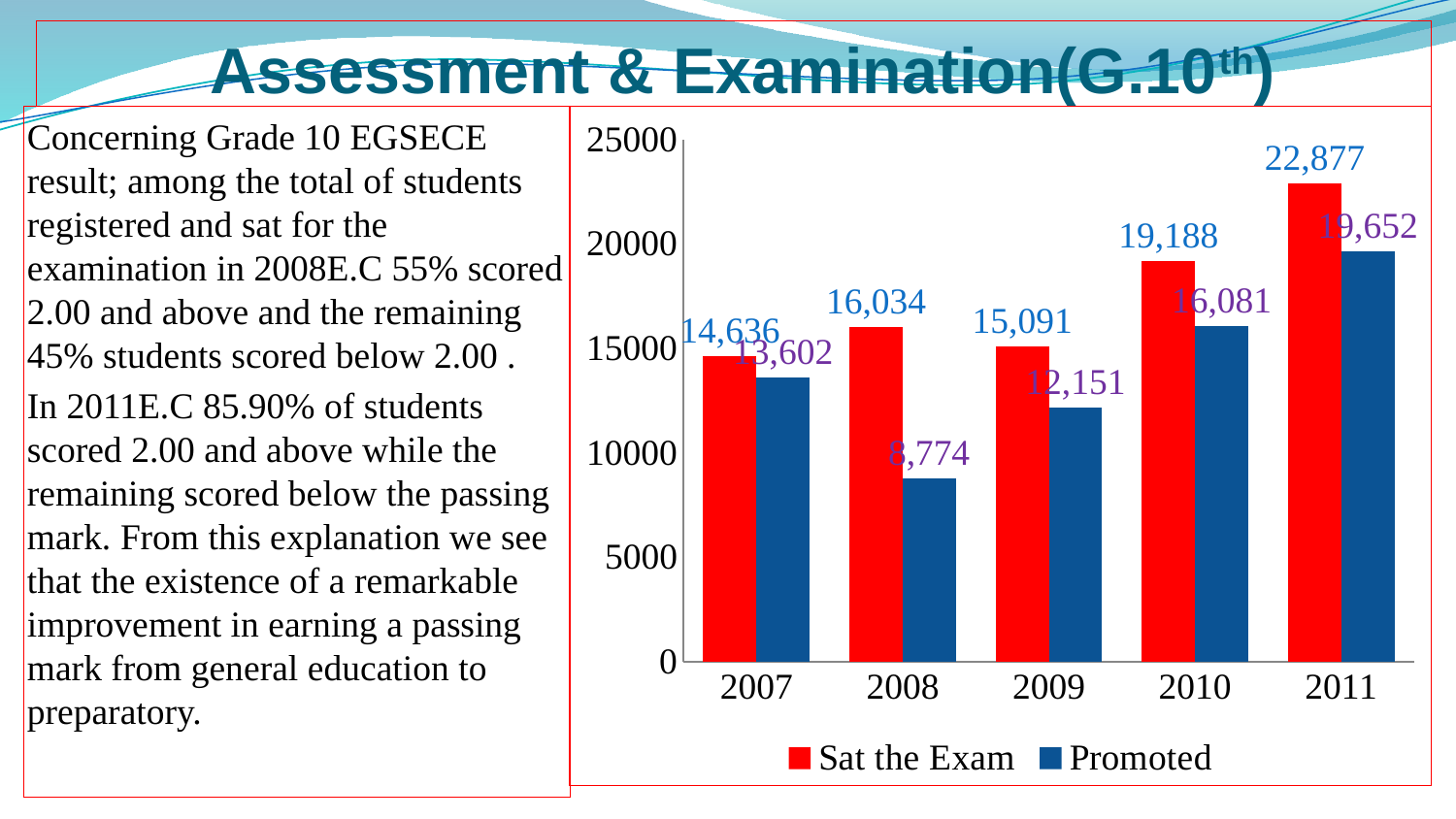
What is the value for Promoted in 2010? 16,081 How many series does the legend list? 2 What is the value for Promoted in 2008? 8,774 Is the value for Sat the Exam in 2010 greater or less than 15000? greater Which year has the highest value for Sat the Exam? 2011 Which colour represents the Promoted series? Blue What is the difference between Sat the Exam and Promoted in 2009? 2,940 What is the value for Sat the Exam in 2011? 22,877 Which year has the lowest value for Promoted? 2008 How many years are shown on the x axis? 5 What type of chart is shown on the slide? Bar chart Which is larger: Promoted in 2007 or Promoted in 2009? Promoted in 2007